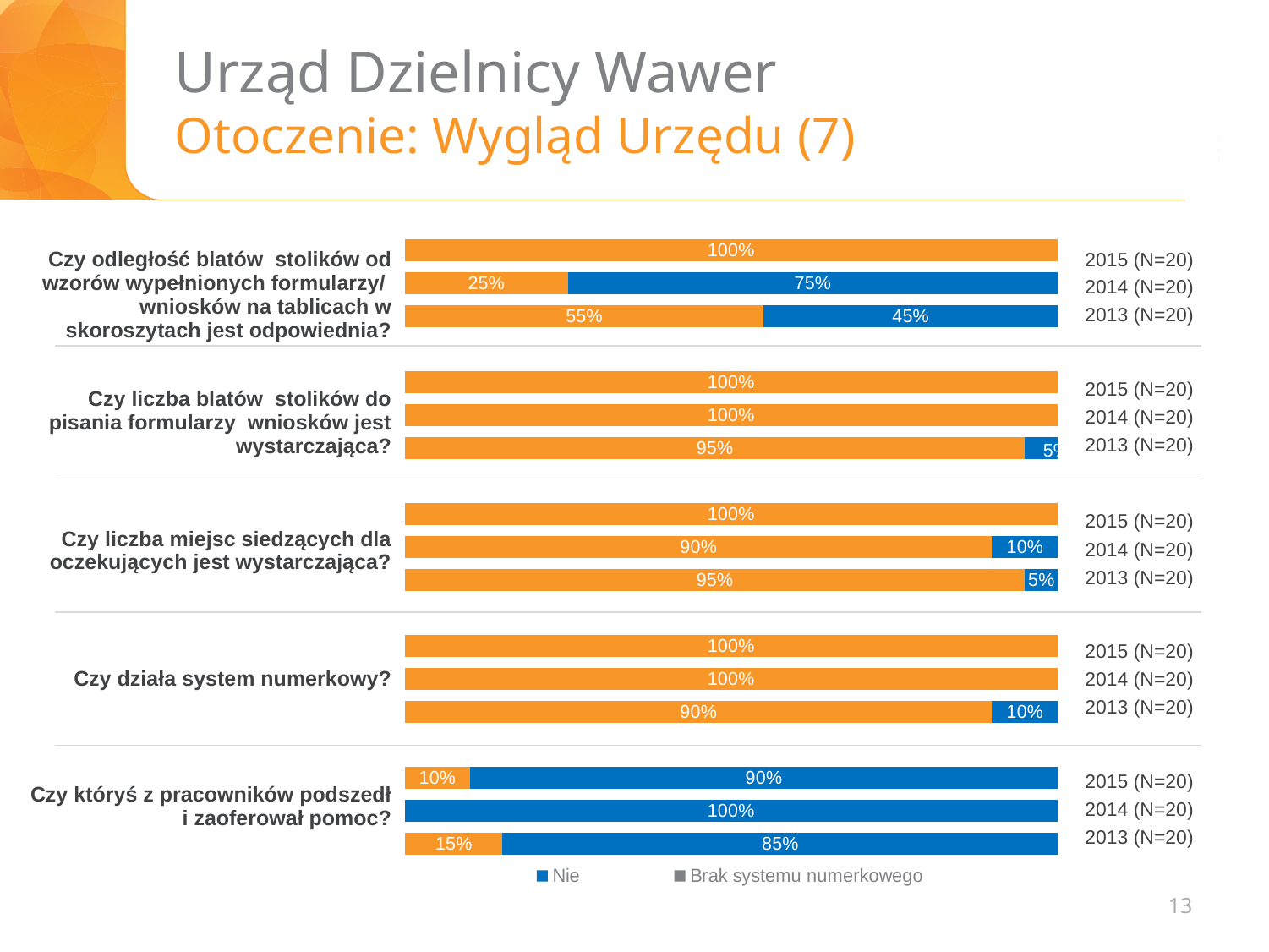
In the chart for "Czy któryś z pracowników podszedł i zaoferował pomoc?", which year has the larger blue (Nie) segment, 2015 or 2013? 2015 In the chart for "Czy któryś z pracowników podszedł i zaoferował pomoc?", what is the value of the orange segment for 2013 (N=20)? 15% In the chart for "Czy działa system numerkowy?", what is the value of the blue (Nie) segment for 2013 (N=20)? 10% In the chart for "Czy liczba miejsc siedzących dla oczekujących jest wystarczająca?", what is the value of the blue (Nie) segment for 2014 (N=20)? 10% How many bars (years) does each chart on the slide show? 3 What kind of chart is used on the slide? Stacked bar chart In the chart for "Czy odległość blatów stolików od wzorów wypełnionych formularzy/ wniosków na tablicach w skoroszytach jest odpowiednia?", what is the value of the orange segment for 2013 (N=20)? 55% In the chart for "Czy odległość blatów stolików od wzorów wypełnionych formularzy/ wniosków na tablicach w skoroszytach jest odpowiednia?", what is the value of the blue (Nie) segment for 2014 (N=20)? 75% In the chart for "Czy odległość blatów stolików od wzorów wypełnionych formularzy/ wniosków na tablicach w skoroszytach jest odpowiednia?", which year has the largest orange segment? 2015 In the chart for "Czy odległość blatów stolików od wzorów wypełnionych formularzy/ wniosków na tablicach w skoroszytach jest odpowiednia?", what is the difference between the orange and blue segments for 2013 (N=20)? 10 percentage points In the chart for "Czy któryś z pracowników podszedł i zaoferował pomoc?", what is the value of the blue (Nie) segment for 2015 (N=20)? 90% What sample size (N) is shown for each year on the slide? N=20